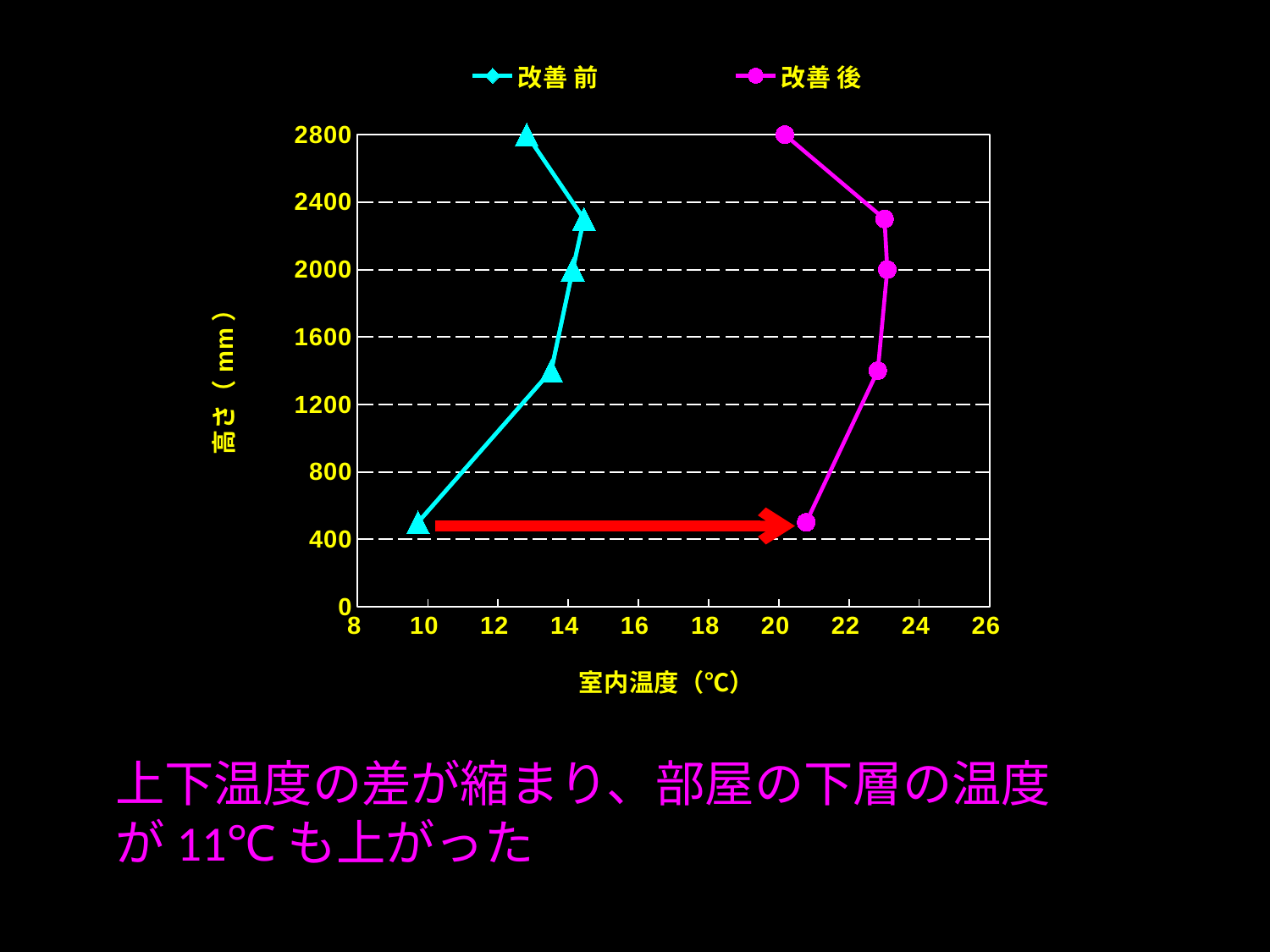
For the 改善後 series, is the temperature at 2800 mm higher or lower than at 2000 mm? lower What kind of chart is shown on the slide? line chart Is the 改善前 temperature at a height of 2800 mm greater or less than 14? less What is the label of the horizontal axis? 室内温度（℃） Is the 改善前 temperature at the lowest plotted height (about 400 mm) greater or less than 12? less Is the 改善後 temperature at a height of 2000 mm greater or less than 22? greater How many data points are plotted for the 改善前 series? 5 At the lowest plotted height, which series shows the higher room temperature, 改善前 or 改善後? 改善後 How many series does the legend list? 2 What are the two series named in the legend? 改善前 and 改善後 Which series reaches the highest room temperature on the chart? 改善後